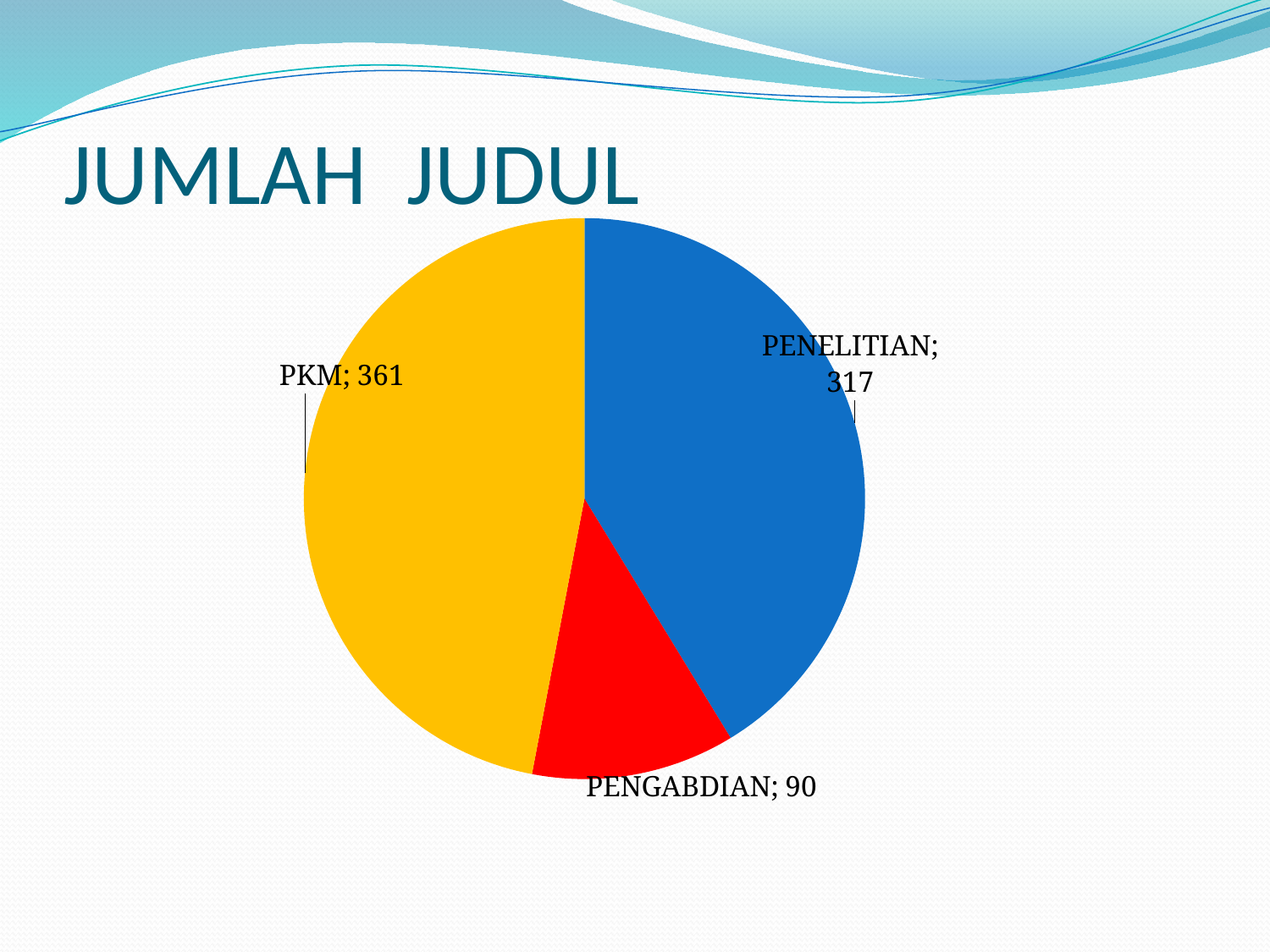
What is the value for PENGABDIAN? 90 What is the total of all the slices in the pie chart? 768 What is the difference between the values for PKM and PENELITIAN? 44 What type of chart is shown on the slide? pie chart Which category has the smallest slice of the pie? PENGABDIAN What is the value for PKM? 361 How many categories are shown in the pie chart? 3 What is the title of the chart on the slide? JUMLAH JUDUL Which is larger, the value for PENELITIAN or the value for PENGABDIAN? PENELITIAN What is the value for PENELITIAN? 317 What is the difference between the values for PENELITIAN and PENGABDIAN? 227 Which category has the largest slice of the pie? PKM